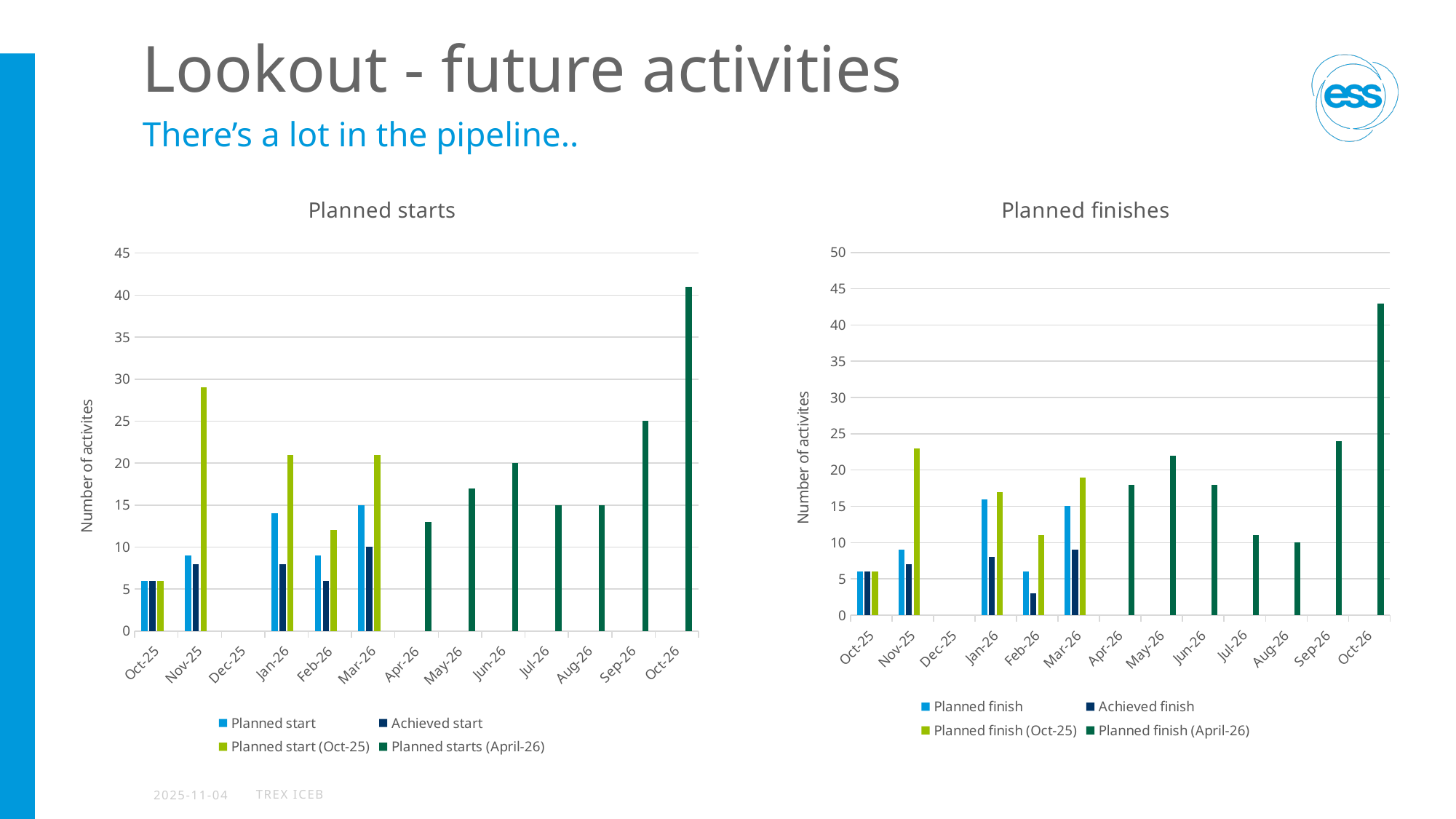
In the "Planned starts" chart, is the Planned start (Oct-25) value for Nov-25 greater or less than 25? greater In the "Planned finishes" chart, is the Planned finish (April-26) value for Oct-26 greater or less than 40? greater How many months are shown on the x axis of the "Planned starts" chart? 13 In the "Planned finishes" chart, which is larger for Feb-26: the Planned finish bar or the Achieved finish bar? Planned finish What kind of chart is the "Planned starts" chart? bar chart In the "Planned starts" chart, which is larger for Nov-25: the Planned start bar or the Planned start (Oct-25) bar? Planned start (Oct-25) What is the y-axis label of the "Planned finishes" chart? Number of activities In the "Planned finishes" chart, which month has the highest Planned finish (April-26) bar? Oct-26 In the "Planned starts" chart, which month has the highest Planned starts (April-26) bar? Oct-26 How many series does the legend of the "Planned finishes" chart list? 4 In the "Planned finishes" chart, is the Planned finish (April-26) value for Aug-26 greater or less than 15? less